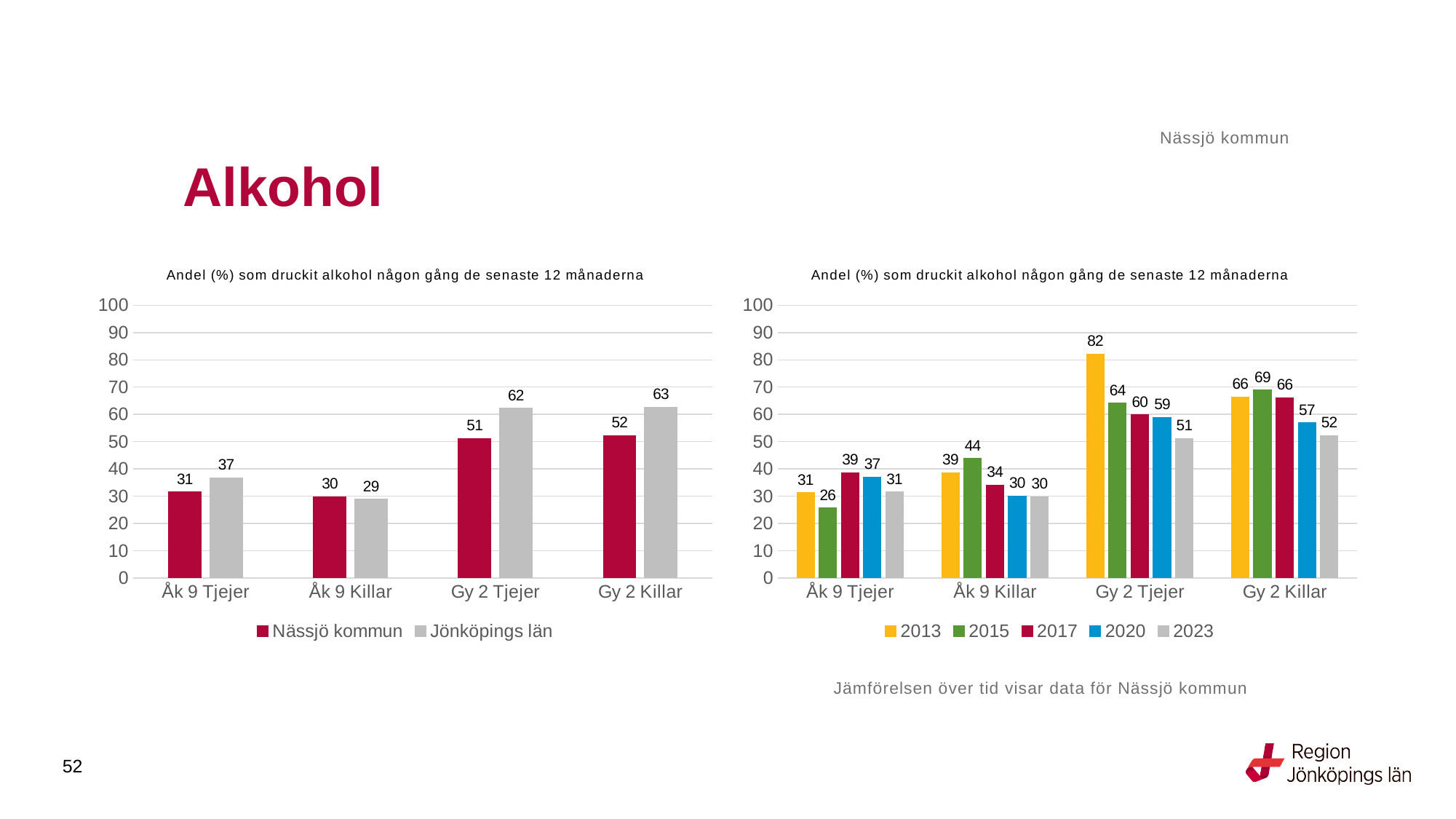
In the left chart, what is the difference between Jönköpings län and Nässjö kommun for Gy 2 Killar? 11 In the right chart, which is larger for Åk 9 Killar: the value for 2015 or the value for 2017? 2015 In the right chart, which year has the lowest value for Åk 9 Tjejer? 2015 In the left chart, which category has the highest value for Jönköpings län? Gy 2 Killar In the left chart, what is the value for Jönköpings län for Åk 9 Killar? 29 In the left chart, what is the value for Nässjö kommun for Gy 2 Tjejer? 51 In the right chart, how many series does the legend list? 5 In the right chart, do the values for Gy 2 Tjejer rise or fall from 2013 to 2023? fall In the left chart, how many series does the legend list? 2 In the right chart, what is the value for 2020 for Gy 2 Killar? 57 What kind of chart is the right chart? bar chart In the right chart, what is the value for 2013 for Gy 2 Tjejer? 82